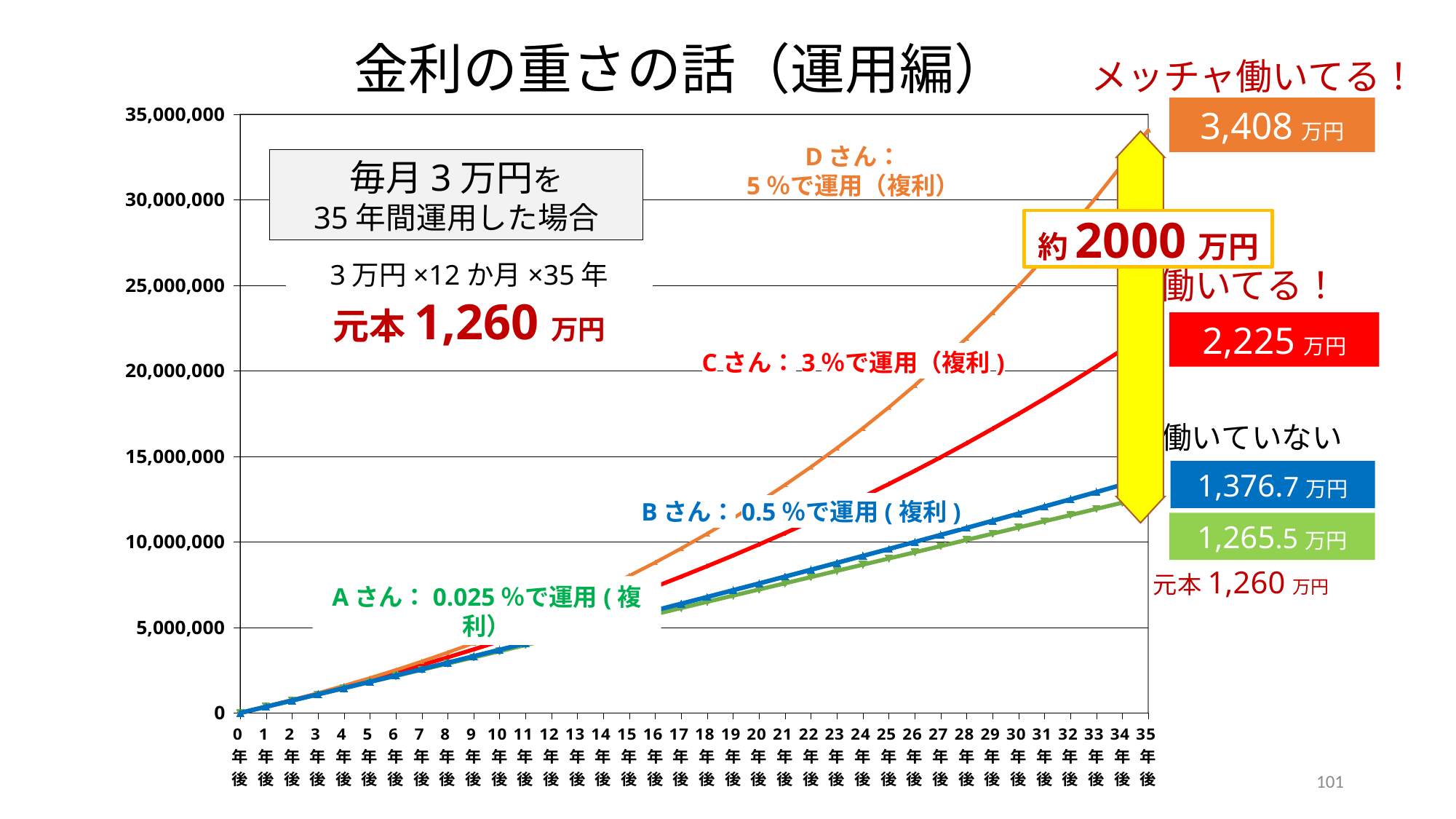
Which series reaches the lowest value at the end of the chart? Aさん (0.025%で運用) What is the difference between the final values of Dさん and Cさん? 1,183万円 Which series reaches the highest value at the end of the chart? Dさん (5%で運用) What is the final value after 35 years for Aさん (0.025% compound)? 1,265.5万円 Do the values of each series rise or fall as the years increase along the x axis? rise Which has a larger final value, Bさん or Aさん? Bさん What kind of chart is shown on the slide? line chart What is the final value after 35 years for Bさん (0.5% compound)? 1,376.7万円 What is the final value after 35 years for Cさん (3% compound)? 2,225万円 Is the value for Cさん at 35年後 greater or less than 20,000,000? greater What is the title of the slide? 金利の重さの話（運用編） What is the final value after 35 years for Dさん (5% compound)? 3,408万円